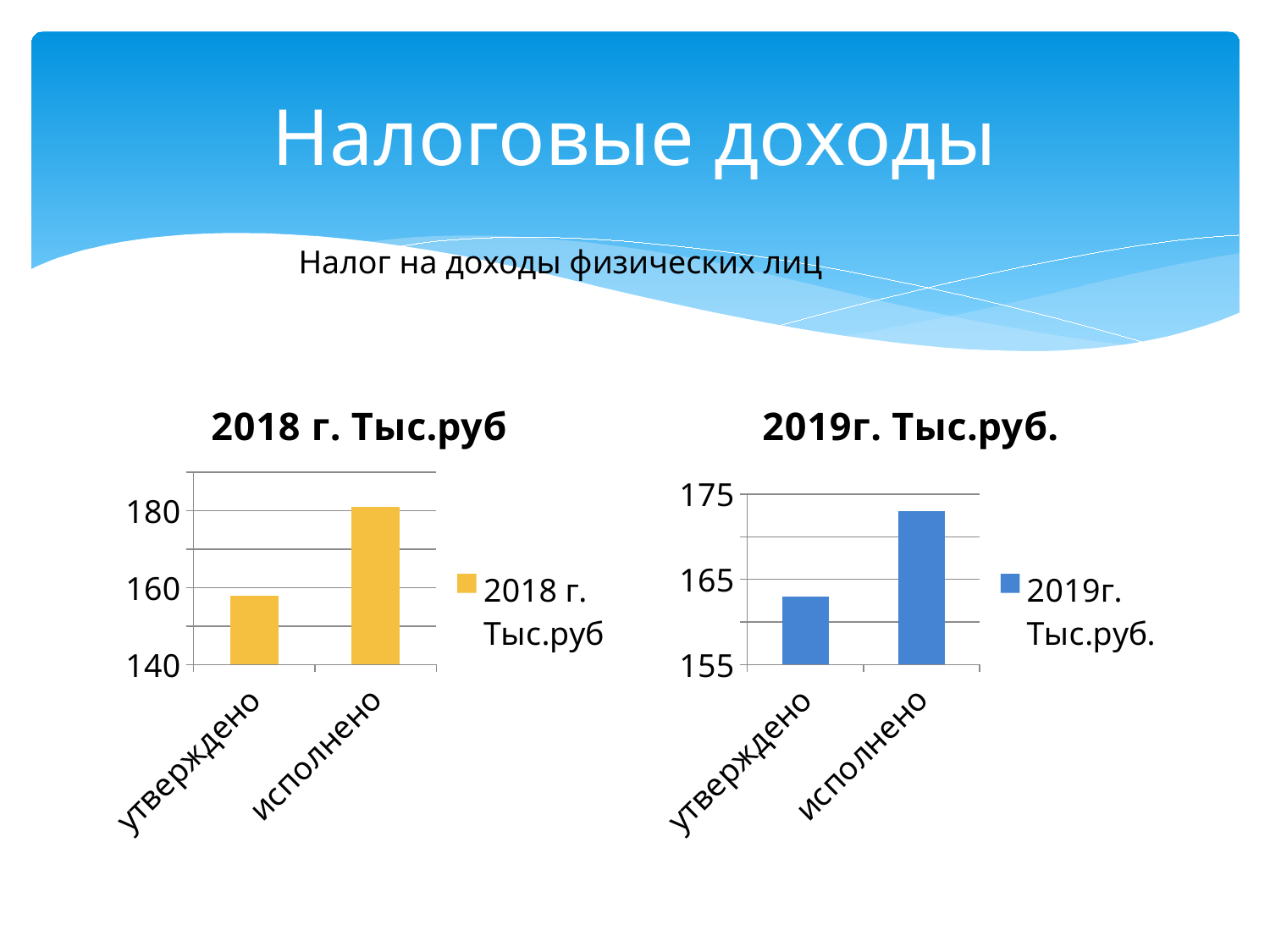
What colour are the bars in the "2019г. Тыс.руб." chart? blue In the "2018 г. Тыс.руб" chart, is the value for исполнено greater or less than 170? greater In the "2019г. Тыс.руб." chart, which is larger: утверждено or исполнено? исполнено In the "2019г. Тыс.руб." chart, is the value for исполнено greater or less than 170? greater How many series does the legend of the "2019г. Тыс.руб." chart list? 1 In the "2019г. Тыс.руб." chart, which category has the lowest value? утверждено In the "2018 г. Тыс.руб" chart, which category has the highest value? исполнено What type of chart is the "2019г. Тыс.руб." chart? bar chart In the "2019г. Тыс.руб." chart, is the value for утверждено greater or less than 165? less What type of chart is the "2018 г. Тыс.руб" chart? bar chart How many categories are shown in the "2018 г. Тыс.руб" chart? 2